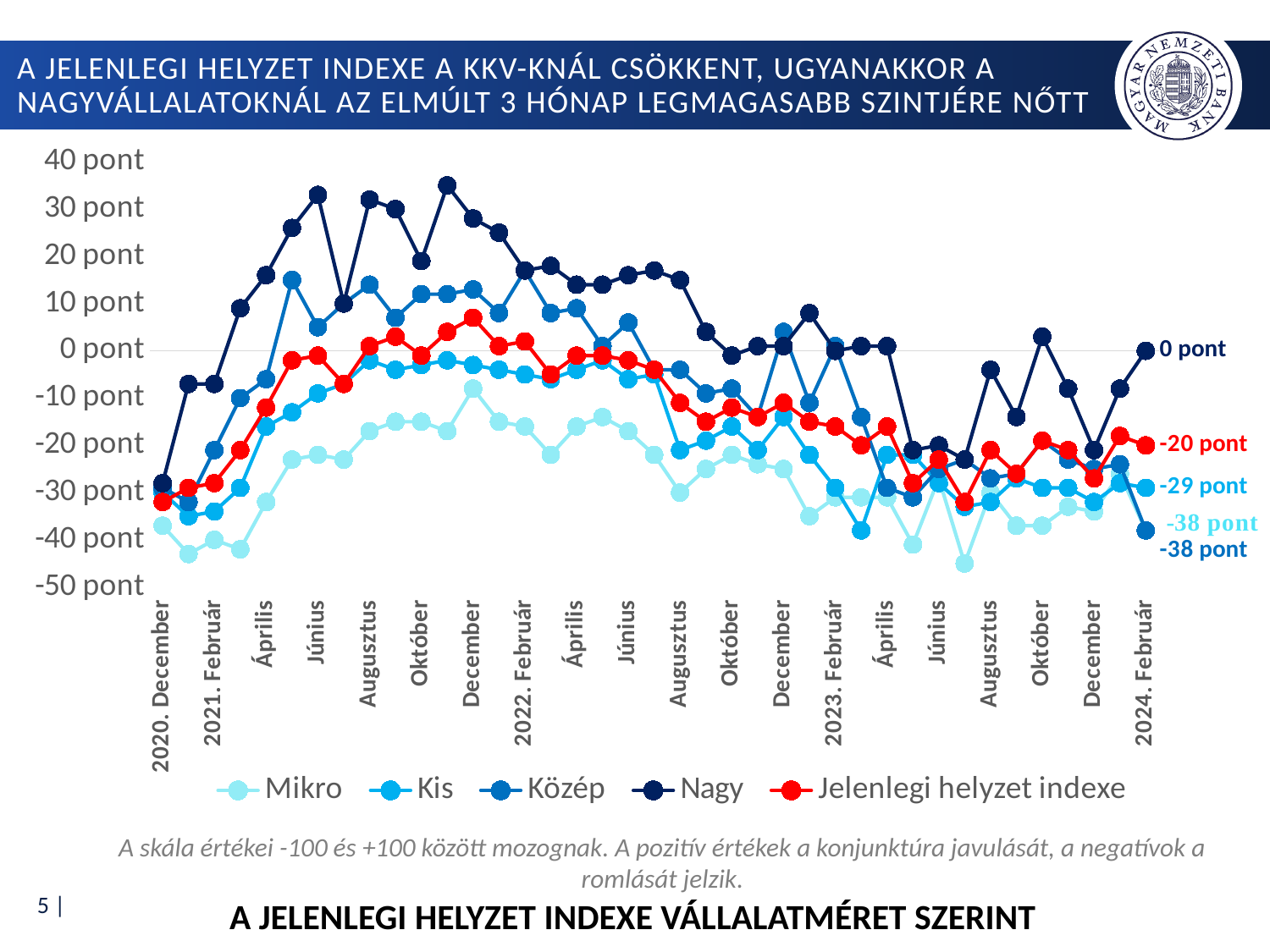
What is the difference between the Nagy value and the Jelenlegi helyzet indexe value in 2024. Február? 20 pont What is the title of the chart at the bottom of the slide? A jelenlegi helyzet indexe vállalatméret szerint What is the value of the Nagy series in 2024. Február? 0 pont Which series has the highest value in 2024. Február? Nagy What is the value of the Jelenlegi helyzet indexe series in 2024. Február? -20 pont How many series does the legend list? 5 Is the value for Nagy in December 2021 greater or less than 30 pont? less What kind of chart is shown on the slide? line chart What is the value of the Közép series in 2024. Február? -38 pont Is the value for Mikro in 2020. December greater or less than -30 pont? less Does the Nagy series rise or fall between December 2023 and 2024. Február? rise In 2024. Február, which is larger: the Nagy value or the Közép value? Nagy